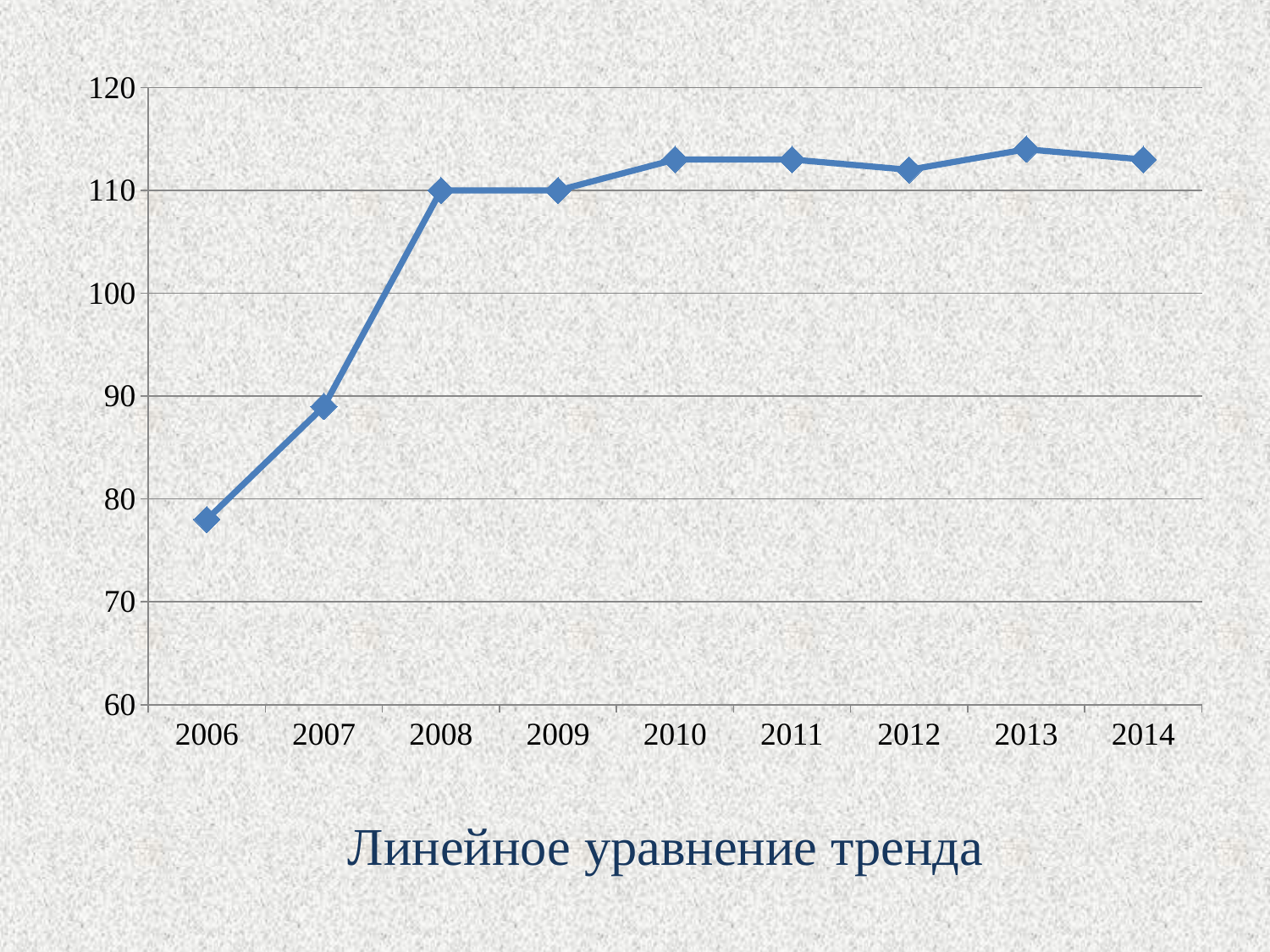
Do the values generally rise or fall from 2006 to 2014? rise Which year has the lowest value on the chart? 2006 Is the value for 2006 greater or less than 80? less What is the value for 2008? 110 How many data points are plotted on the chart? 9 What kind of chart is shown on the slide? line chart Is the value for 2014 greater or less than 120? less Is the value for 2010 greater or less than 110? greater Which is larger, the value for 2007 or the value for 2008? 2008 What is the text shown below the chart? Линейное уравнение тренда What is the value for 2009? 110